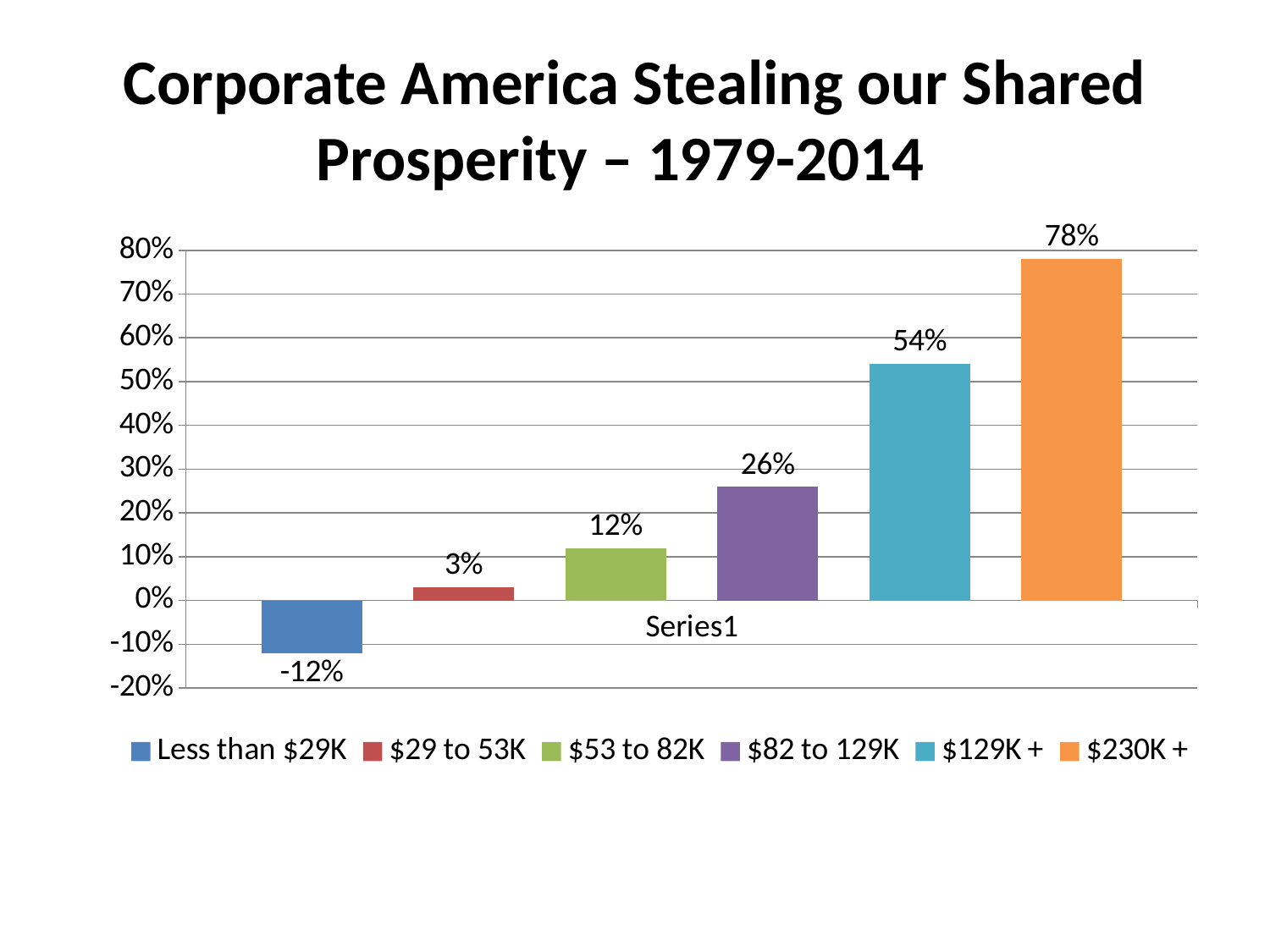
What is the value for the Less than $29K group? -12% What is the title of the slide? Corporate America Stealing our Shared Prosperity – 1979-2014 What is the value for the $82 to 129K group? 26% Which income group has the lowest value? Less than $29K Which income group has the highest value? $230K + What is the value for the $230K + group? 78% Which is larger, the value for $129K + or the value for $82 to 129K? $129K + What kind of chart is shown on the slide? Bar chart What is the difference between the values for $230K + and $129K +? 24% Do the values rise or fall moving from the lowest income group to the highest? Rise How many income groups are shown in the chart? 6 What is the difference between the values for $53 to 82K and $29 to 53K? 9%